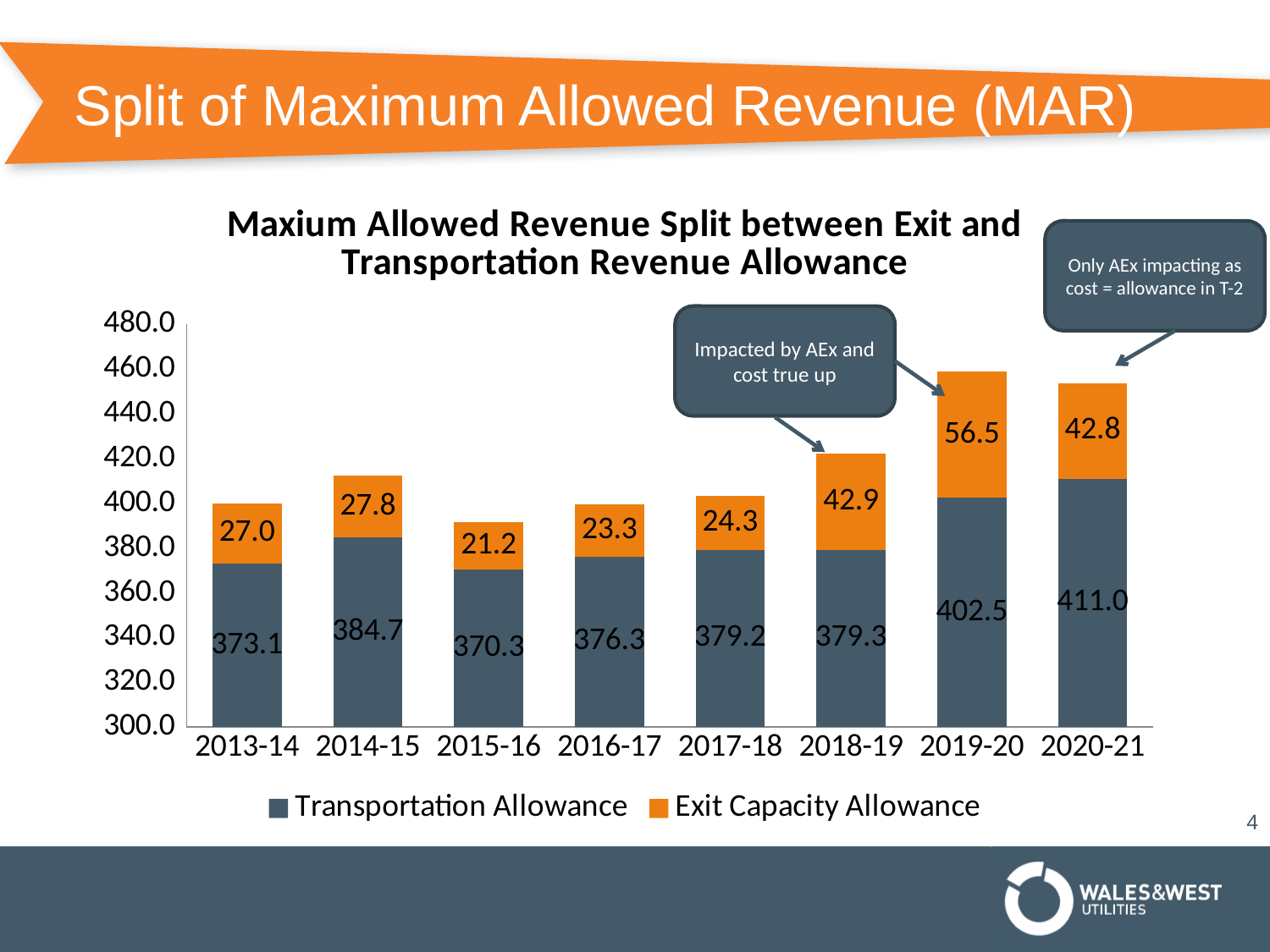
What is the Transportation Allowance value for 2019-20? 402.5 Which colour represents the Exit Capacity Allowance series? Orange Which is larger, the Exit Capacity Allowance in 2018-19 or in 2020-21? 2018-19 How many years are shown on the x axis? 8 What kind of chart is shown on the slide? Stacked bar chart How many series does the legend list? 2 Is the total stacked bar for 2019-20 greater or less than 440.0? greater What is the total of the stacked bar for 2018-19? 422.2 What is the difference between the Transportation Allowance in 2020-21 and in 2019-20? 8.5 What is the Exit Capacity Allowance value for 2015-16? 21.2 Which year has the highest Exit Capacity Allowance? 2019-20 Which year has the lowest Transportation Allowance? 2015-16